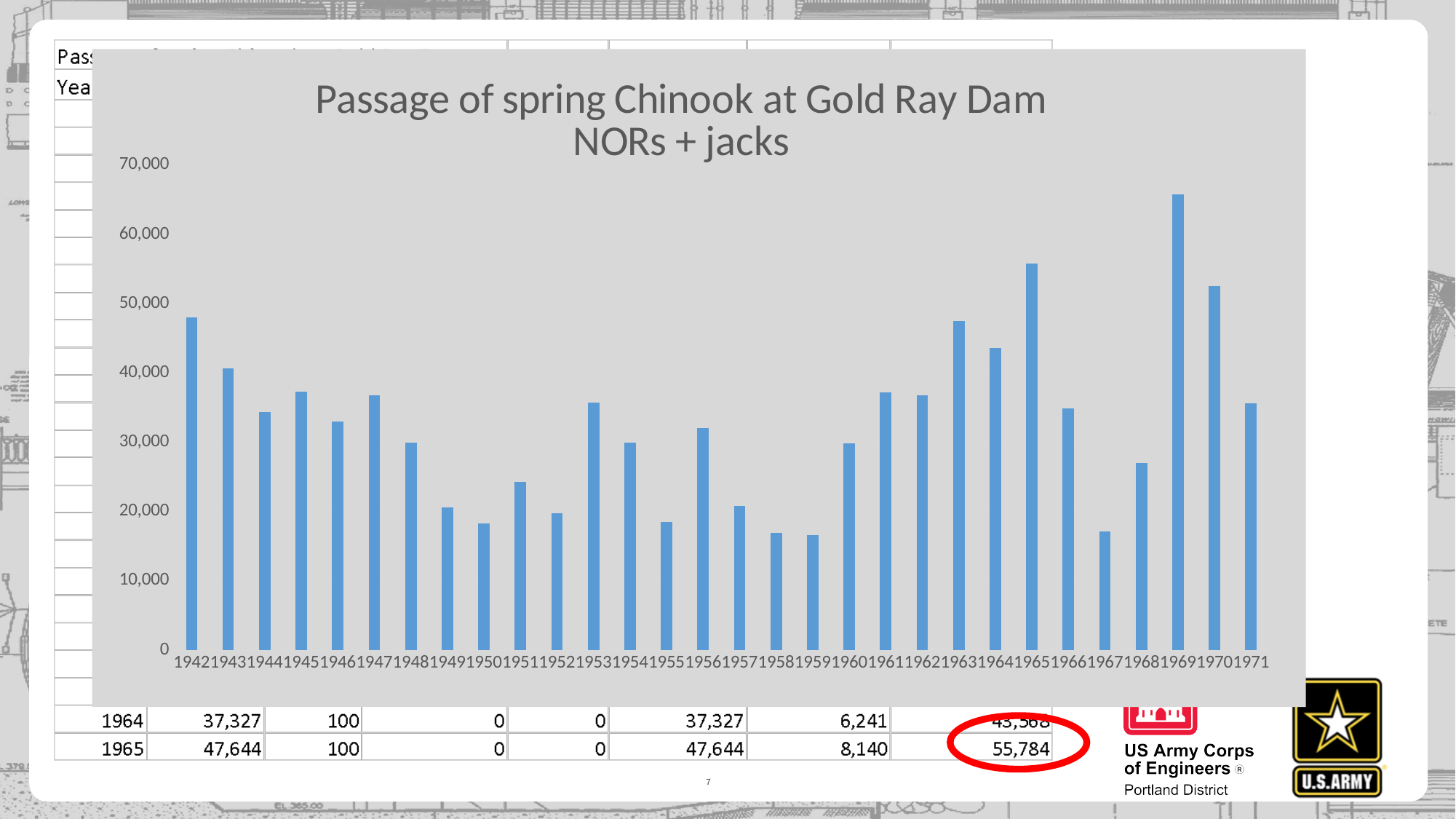
Is the value for 1967 greater or less than 20,000? less Is the value for 1965 greater or less than 50,000? greater Is the value for 1969 greater or less than 60,000? greater Which year has the larger value, 1963 or 1964? 1963 How many years are plotted on the x axis of the chart? 30 Which year has the larger value, 1942 or 1943? 1942 Do the values generally rise or fall from 1942 to 1950? fall What kind of chart is shown on the slide? bar chart Which year has the highest passage value in the chart? 1969 What is the title of the chart? Passage of spring Chinook at Gold Ray Dam NORs + jacks